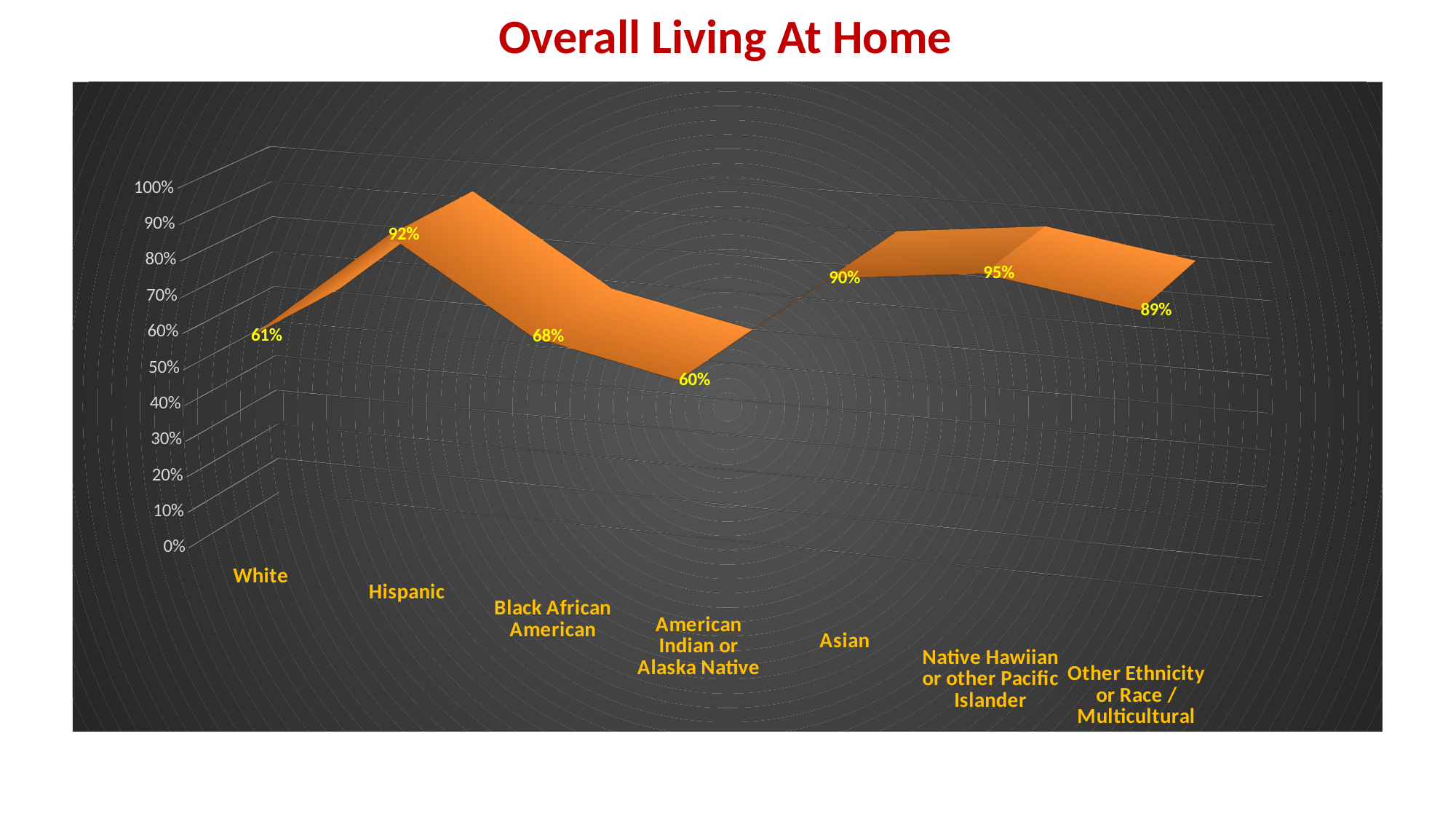
Which is larger, the value for Asian or the value for Black African American? Asian Which category has the lowest value? American Indian or Alaska Native What is the value for American Indian or Alaska Native? 60% What is the title of the chart? Overall Living At Home What is the value for Hispanic? 92% What is the value for Other Ethnicity or Race / Multicultural? 89% What is the difference between the values for Native Hawiian or other Pacific Islander and Asian? 5% Which category has the highest value? Native Hawiian or other Pacific Islander What kind of chart is this? 3D line chart How many categories are shown on the x axis? 7 What is the value for Black African American? 68% What is the difference between the values for Hispanic and White? 31%